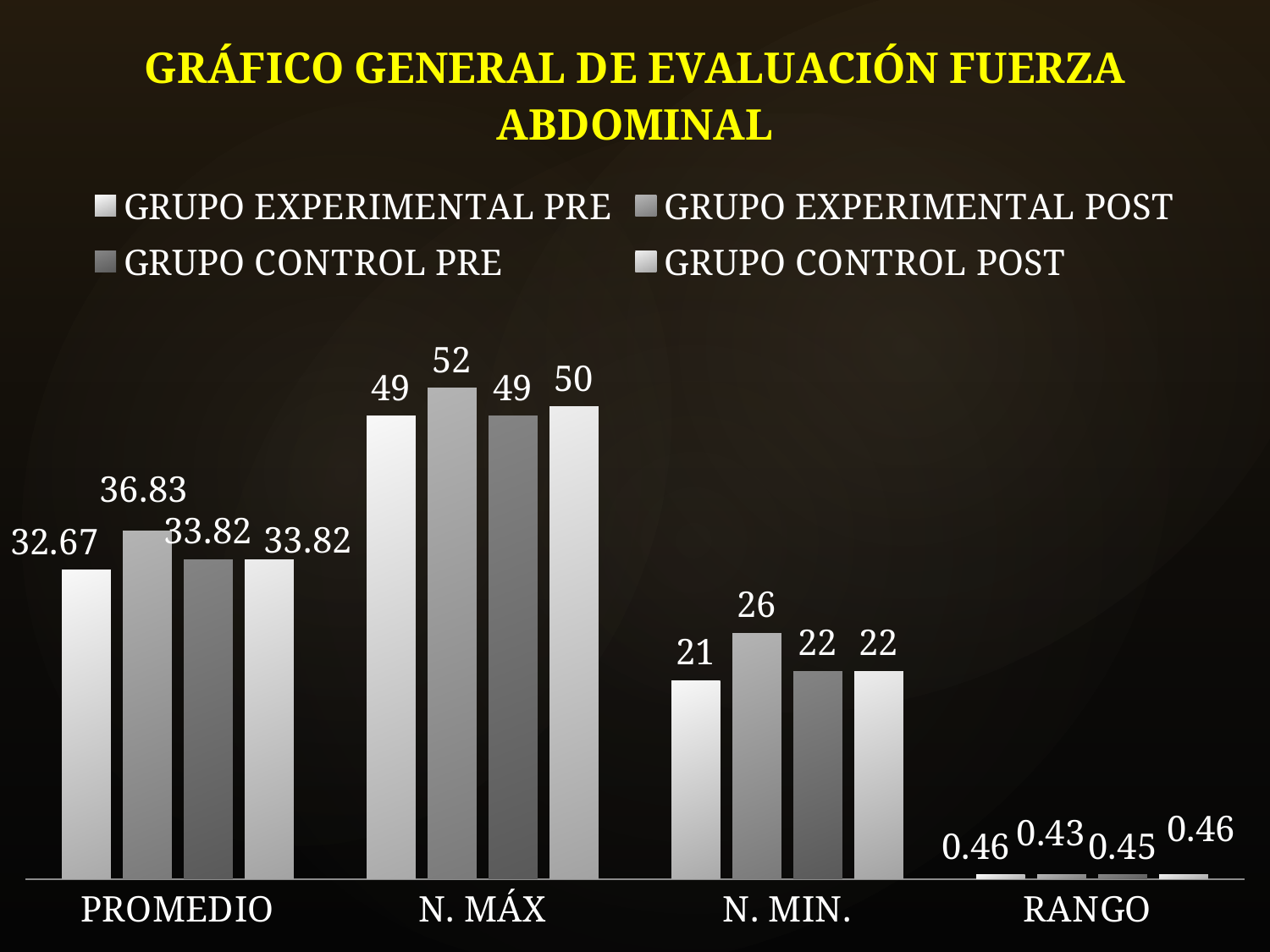
What kind of chart is shown on the slide? Bar chart What is the value for GRUPO EXPERIMENTAL POST in the RANGO category? 0.43 What is the value for GRUPO EXPERIMENTAL PRE in the N. MÁX category? 49 What is the value for GRUPO CONTROL POST in the N. MIN. category? 22 What is the difference between GRUPO EXPERIMENTAL POST and GRUPO EXPERIMENTAL PRE in the N. MIN. category? 5 How many series does the legend list? 4 Which is larger in the N. MÁX category: GRUPO CONTROL PRE or GRUPO CONTROL POST? GRUPO CONTROL POST Which series has the highest value in the N. MÁX category? GRUPO EXPERIMENTAL POST What is the value for GRUPO EXPERIMENTAL POST in the PROMEDIO category? 36.83 Which series has the lowest value in the N. MIN. category? GRUPO EXPERIMENTAL PRE What is the difference between GRUPO EXPERIMENTAL POST and GRUPO EXPERIMENTAL PRE in the PROMEDIO category? 4.16 How many categories are shown on the x axis? 4